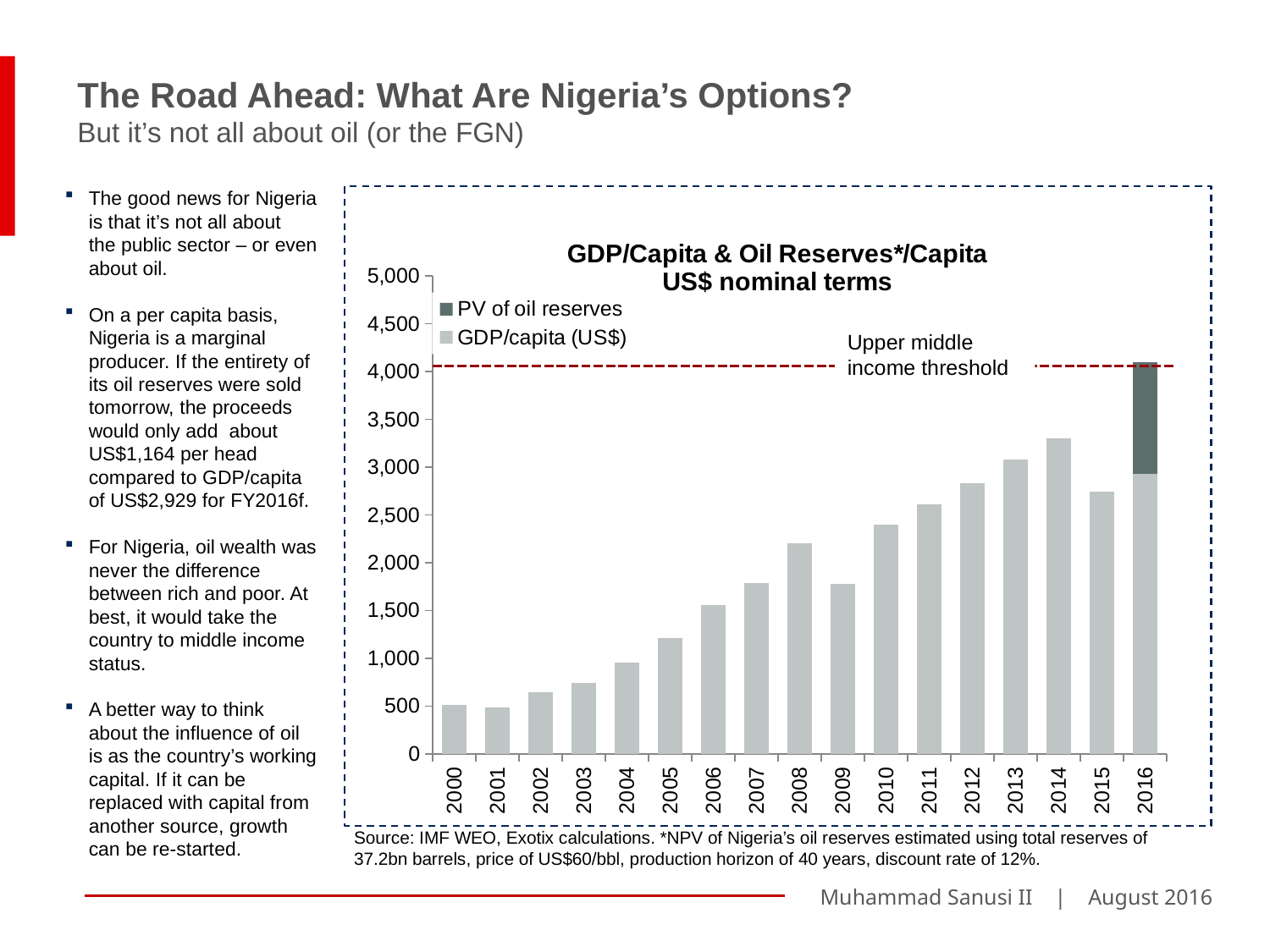
Which year has the highest GDP/capita (US$) bar? 2014 What does the dashed horizontal line on the chart represent? Upper middle income threshold Is the GDP/capita (US$) value for 2009 greater or less than 2,000? less How many series does the chart legend list? 2 Is the GDP/capita (US$) value for 2002 greater or less than 1,000? less Does GDP/capita (US$) generally rise or fall from 2000 to 2014? rise How many years are shown along the x axis of the chart? 17 Is the GDP/capita (US$) value for 2015 greater or less than 3,000? less Which year has the larger GDP/capita (US$) bar, 2014 or 2015? 2014 What kind of chart is shown on the slide? bar chart